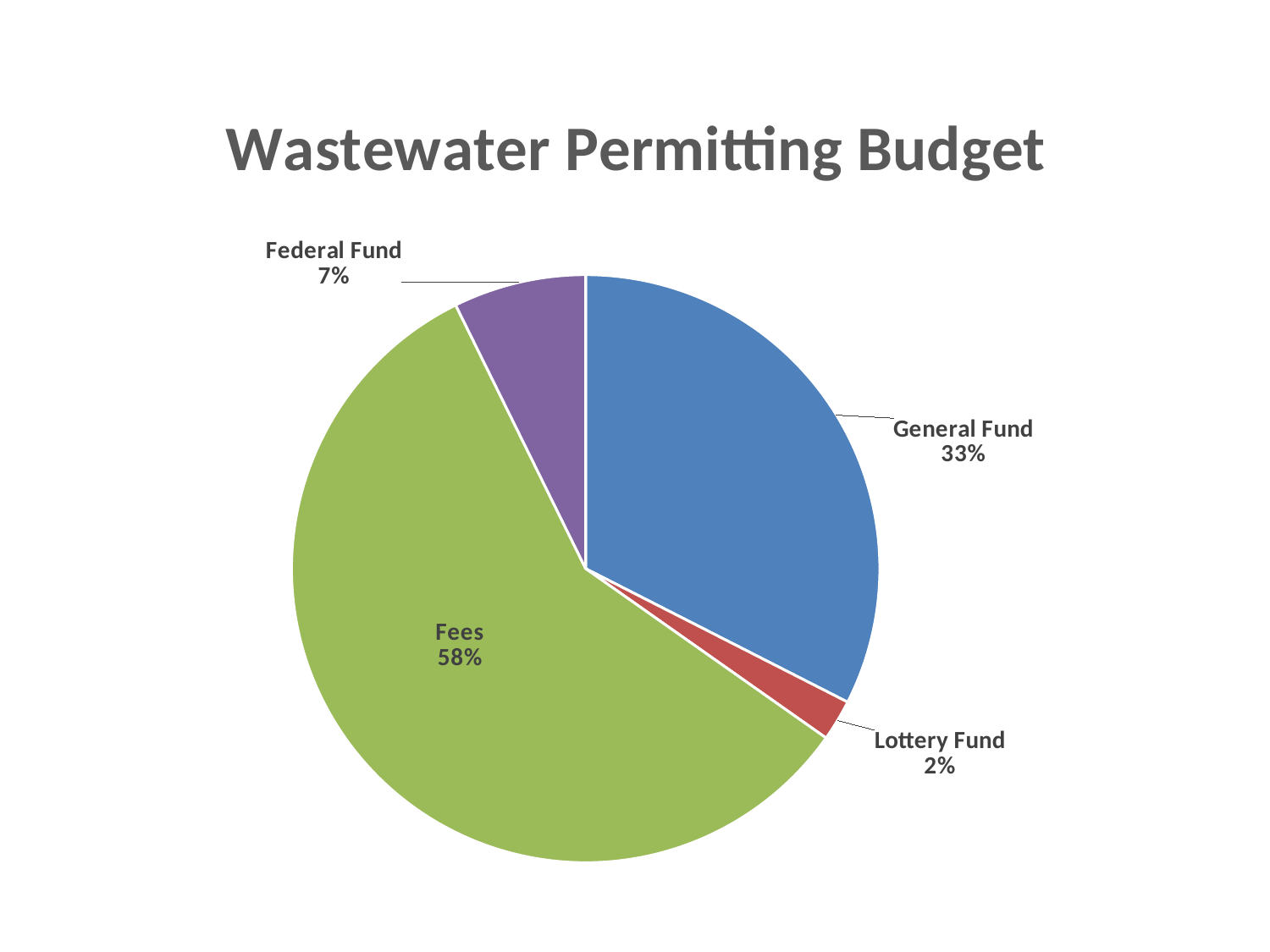
Which is larger, the Federal Fund share or the Lottery Fund share? Federal Fund Which funding source has the smallest share of the budget? Lottery Fund How many slices does the pie chart have? 4 What colour is the Fees slice? green What share of the budget comes from the Lottery Fund? 2% What share of the budget comes from the General Fund? 33% What kind of chart is shown on the slide? pie chart What share of the budget comes from Fees? 58% Which funding source has the largest share of the budget? Fees What is the difference in percentage points between Fees and the General Fund? 25 What share of the budget comes from the Federal Fund? 7% What is the title of the chart? Wastewater Permitting Budget